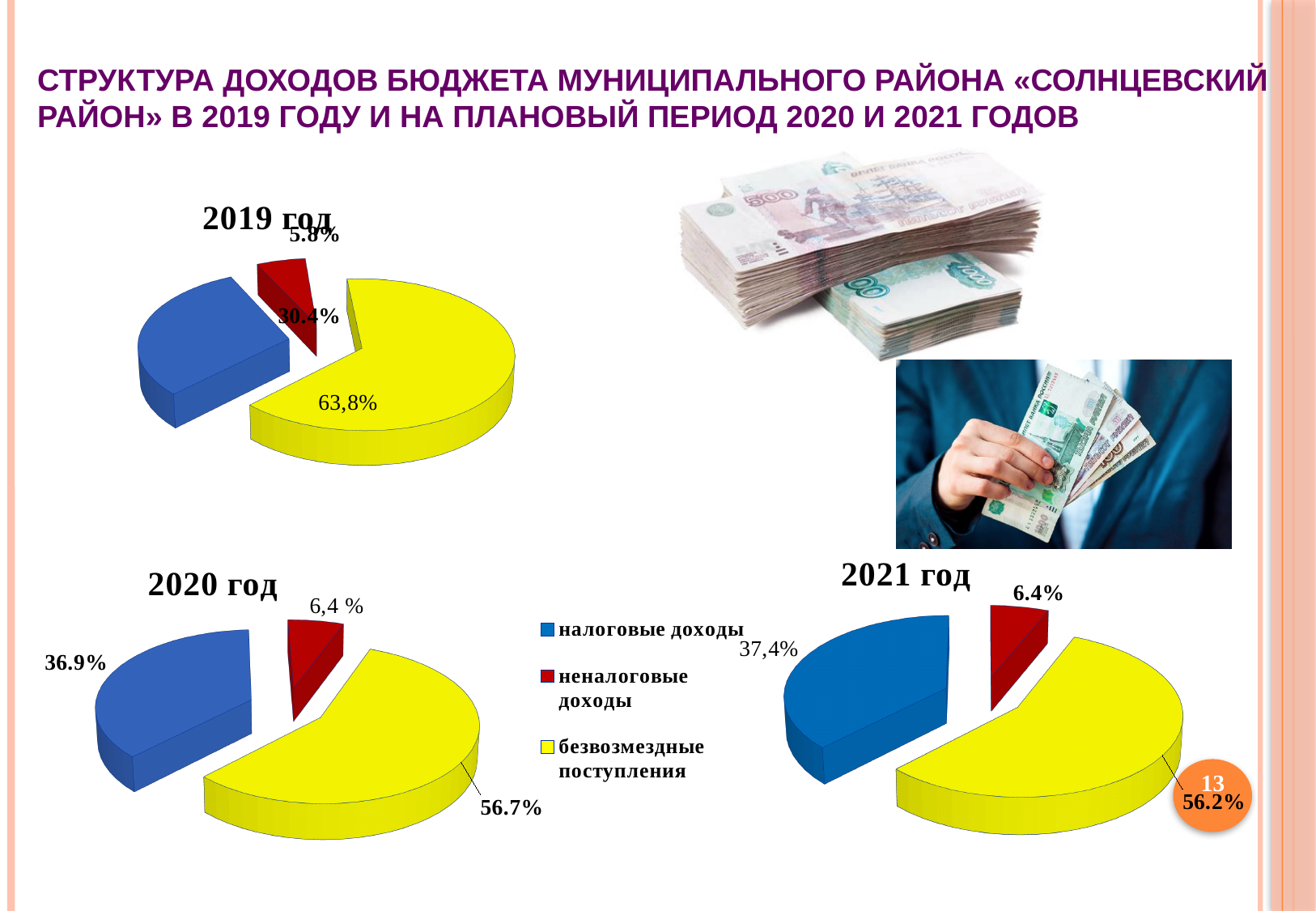
In the 2021 год pie chart, what share is shown for безвозмездные поступления? 56.2% In the 2020 год pie chart, what share is shown for налоговые доходы? 36.9% What type of chart is used for the 2020 год data? pie chart In the 2021 год pie chart, which category has the smallest share? неналоговые доходы In the 2021 год pie chart, what share is shown for налоговые доходы? 37,4% In the 2020 год pie chart, what share is shown for неналоговые доходы? 6,4 % In the legend, which colour represents неналоговые доходы? red In the 2019 год pie chart, what share is shown for налоговые доходы? 30.4% In the 2020 год pie chart, which is larger: налоговые доходы or безвозмездные поступления? безвозмездные поступления In the 2019 год pie chart, which category has the largest share? безвозмездные поступления In the 2019 год pie chart, what share is shown for безвозмездные поступления? 63,8% How many series does the shared legend list? 3